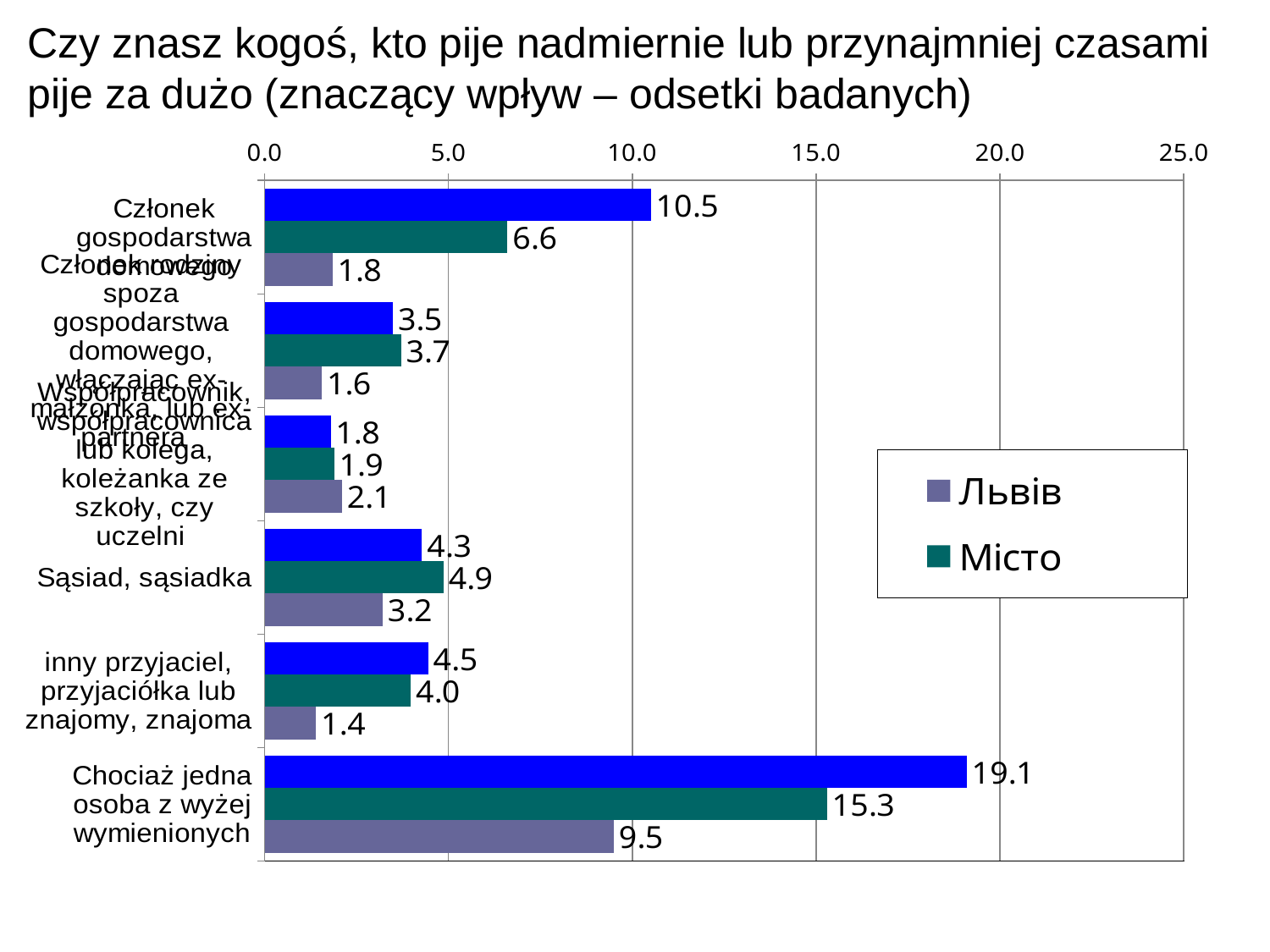
What is the difference between the Місто and Львів values in the category "Chociaż jedna osoba z wyżej wymienionych"? 5.8 Which is larger in the category "Sąsiad, sąsiadka": the Місто value or the Львів value? Місто What is the value for Львів in the category "Chociaż jedna osoba z wyżej wymienionych"? 9.5 What is the maximum value shown on the horizontal axis? 25.0 How many series does the legend list? 2 What is the value for Місто in the category "Chociaż jedna osoba z wyżej wymienionych"? 15.3 What is the value for Місто in the category "inny przyjaciel, przyjaciółka lub znajomy, znajoma"? 4.0 What is the value for Львів in the category "Sąsiad, sąsiadka"? 3.2 What type of chart is shown on the slide? bar chart What is the difference between the Місто and Львів values in the category "inny przyjaciel, przyjaciółka lub znajomy, znajoma"? 2.6 Is the Місто value for "Chociaż jedna osoba z wyżej wymienionych" greater or less than 10.0? greater In which category does Львів have its highest value? Chociaż jedna osoba z wyżej wymienionych